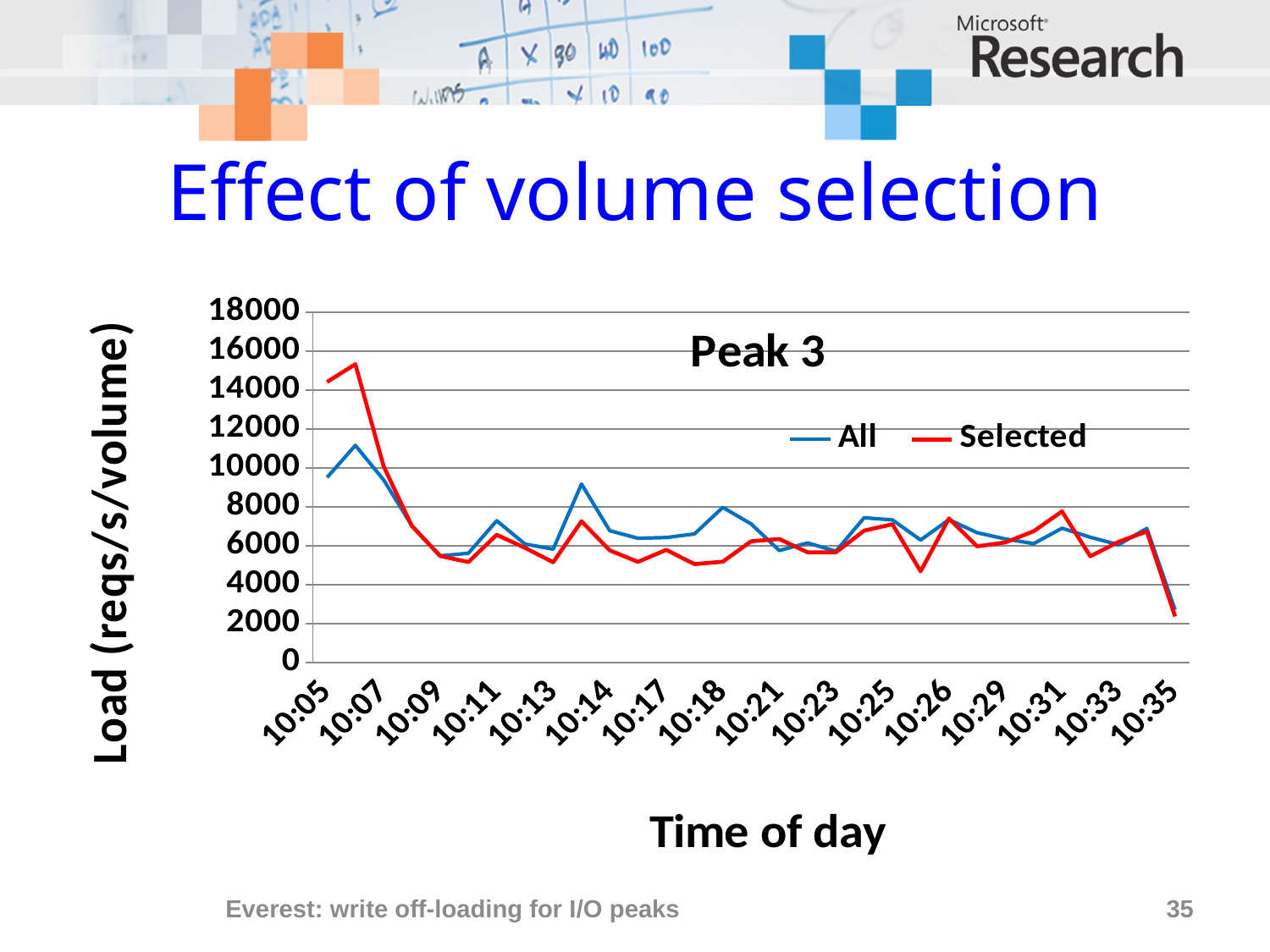
How many series does the chart legend list? 2 How many time labels are shown on the x axis? 16 Is the value for All at 10:35 greater or less than 4000? less Is the value for Selected at 10:35 greater or less than 4000? less Is the value for Selected at 10:05 greater or less than 12000? greater Which colour is used for the Selected series? red What kind of chart is shown on the slide? line chart Overall, do the values rise or fall from 10:05 to 10:35? fall At which time does the Selected series reach its lowest value? 10:35 What is the title of the chart? Peak 3 At 10:05, which series has the higher value, All or Selected? Selected